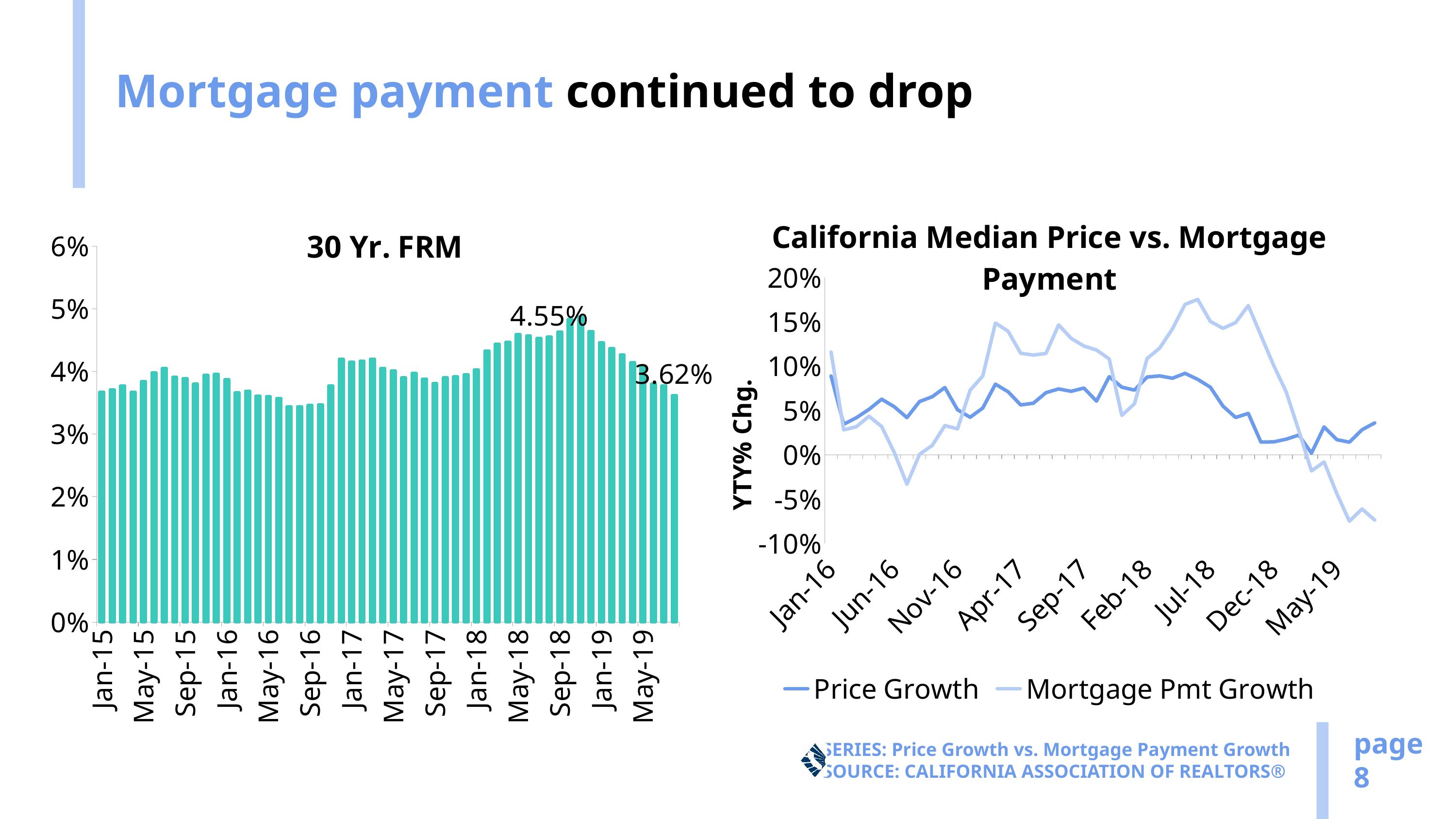
In the 'California Median Price vs. Mortgage Payment' chart, does the Mortgage Pmt Growth line rise or fall from Jul-18 to May-19? fall How many series does the legend of the 'California Median Price vs. Mortgage Payment' chart list? 2 In the 'California Median Price vs. Mortgage Payment' chart, which series is higher at May-19, Price Growth or Mortgage Pmt Growth? Price Growth In the '30 Yr. FRM' chart, is the value for Sep-18 greater or less than 4%? greater In the '30 Yr. FRM' chart, what value is labeled on the last bar? 3.62% In the '30 Yr. FRM' chart, what is the difference between the labeled peak value and the labeled final value? 0.93% What is the y-axis label of the 'California Median Price vs. Mortgage Payment' chart? YTY% Chg. What kind of chart is the 'California Median Price vs. Mortgage Payment' chart on the right? line chart What kind of chart is the '30 Yr. FRM' chart on the left? bar chart In the '30 Yr. FRM' chart, is the value for Jan-15 greater or less than 4%? less In the '30 Yr. FRM' chart, what is the highest value labeled on the bars? 4.55%